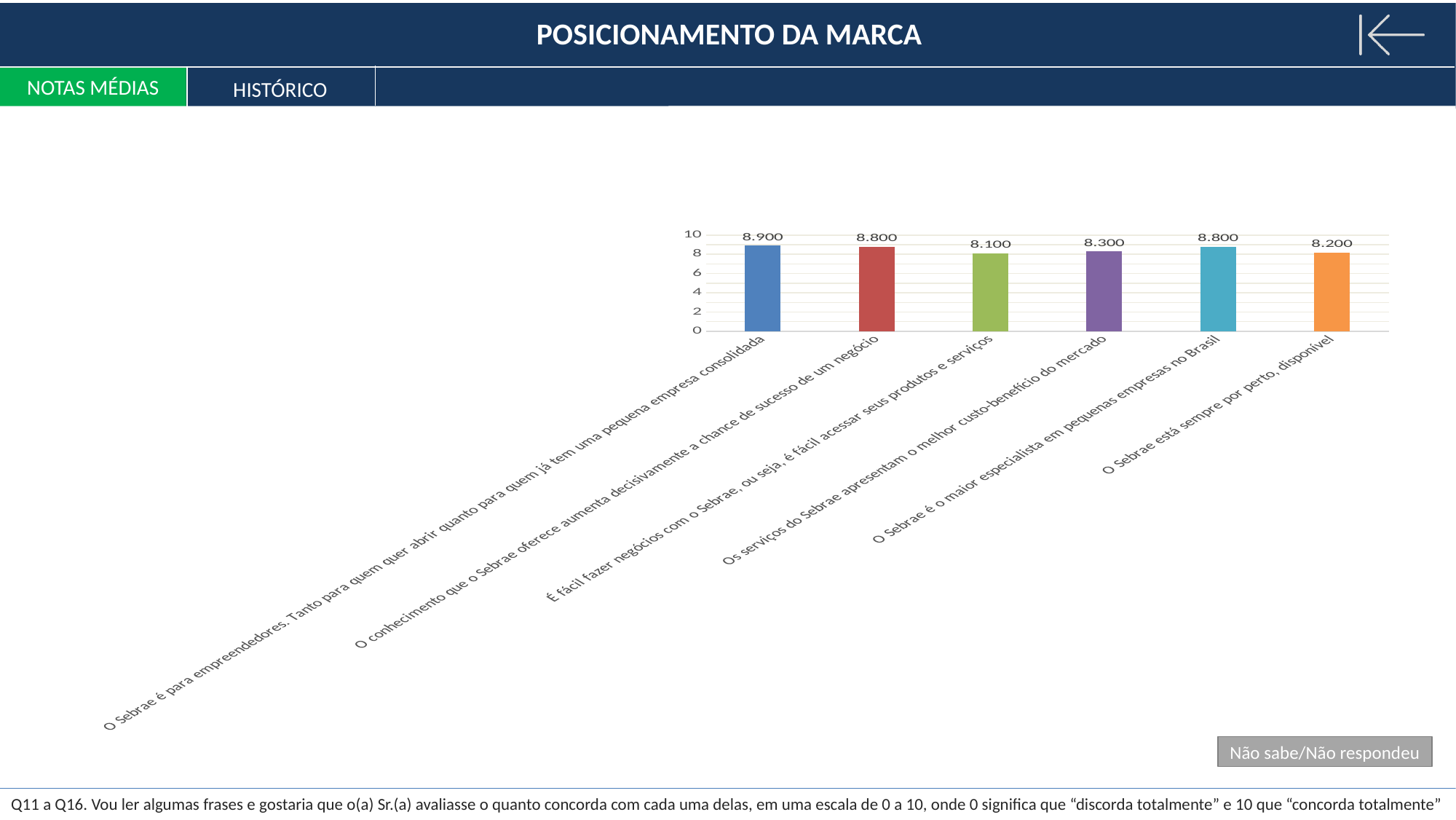
Is the value for "É fácil fazer negócios com o Sebrae, ou seja, é fácil acessar seus produtos e serviços" greater or less than 6? greater What is the maximum value shown on the vertical axis of the chart? 10 Which is larger: the value for "Os serviços do Sebrae apresentam o melhor custo-benefício do mercado" or the value for "O Sebrae está sempre por perto, disponível"? Os serviços do Sebrae apresentam o melhor custo-benefício do mercado Which statement has the highest value? O Sebrae é para empreendedores. Tanto para quem quer abrir quanto para quem já tem uma pequena empresa consolidada What is the difference between the highest value (8.900) and the lowest value (8.100)? 0.800 What kind of chart is shown on the slide? bar chart How many bars are shown in the chart? 6 What is the value for "O Sebrae está sempre por perto, disponível"? 8.200 What is the value for "Os serviços do Sebrae apresentam o melhor custo-benefício do mercado"? 8.300 What is the value for "O Sebrae é o maior especialista em pequenas empresas no Brasil"? 8.800 What colour is the bar for "O Sebrae está sempre por perto, disponível"? orange Which statement has the lowest value? É fácil fazer negócios com o Sebrae, ou seja, é fácil acessar seus produtos e serviços